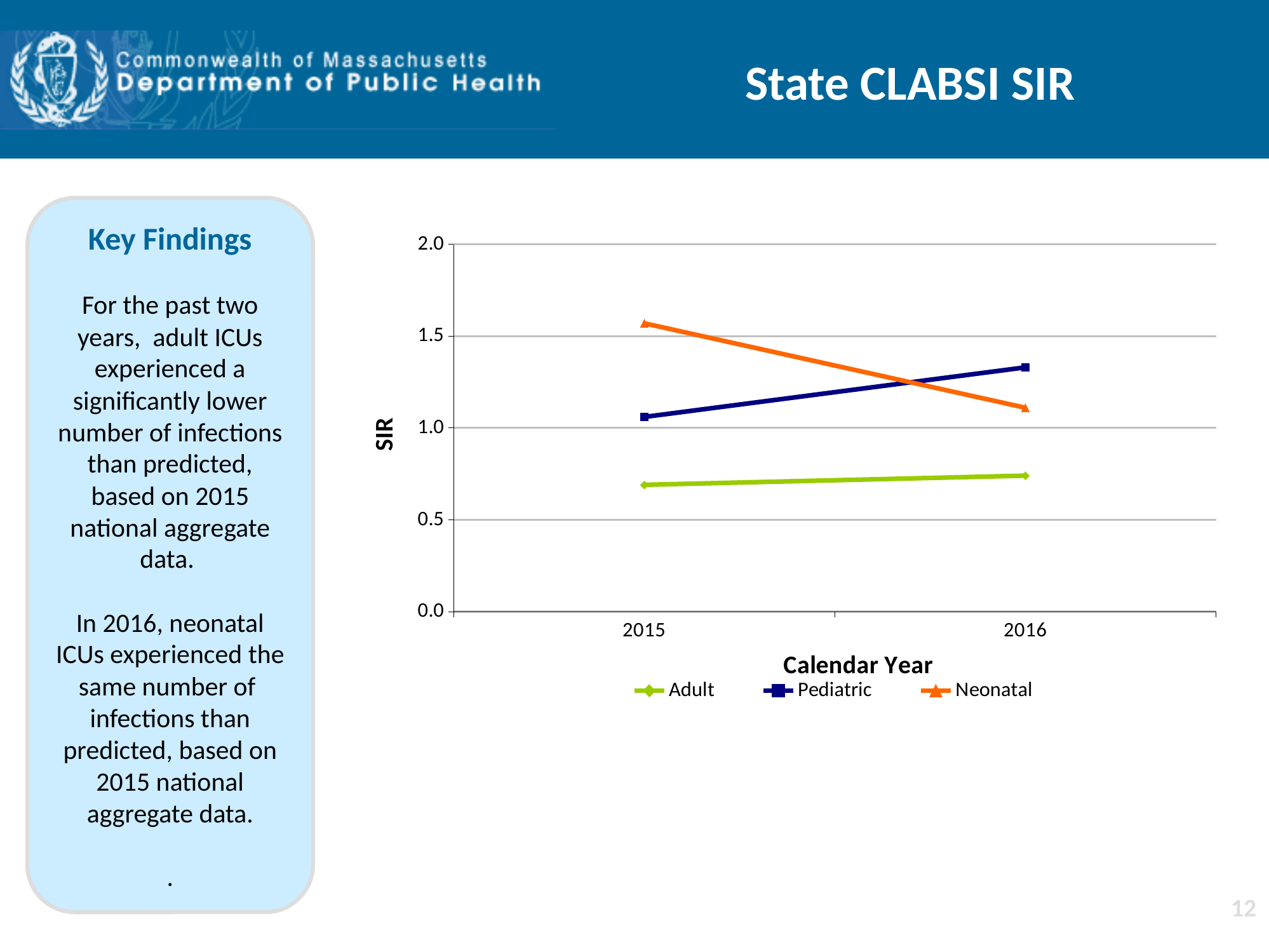
Is the Adult SIR in 2015 greater or less than 1.0? less Does the Neonatal SIR rise or fall from 2015 to 2016? Fall In 2015, which is larger, the Neonatal SIR or the Pediatric SIR? Neonatal How many series does the legend list? 3 How many calendar years are plotted on the x axis? 2 Is the Neonatal SIR in 2015 greater or less than 1.5? greater Which series has the highest SIR in 2016? Pediatric Does the Pediatric SIR rise or fall from 2015 to 2016? Rise What is the title of the x axis? Calendar Year Which series has the highest SIR in 2015? Neonatal What kind of chart is shown on the slide? Line chart Which series has the lowest SIR in 2016? Adult